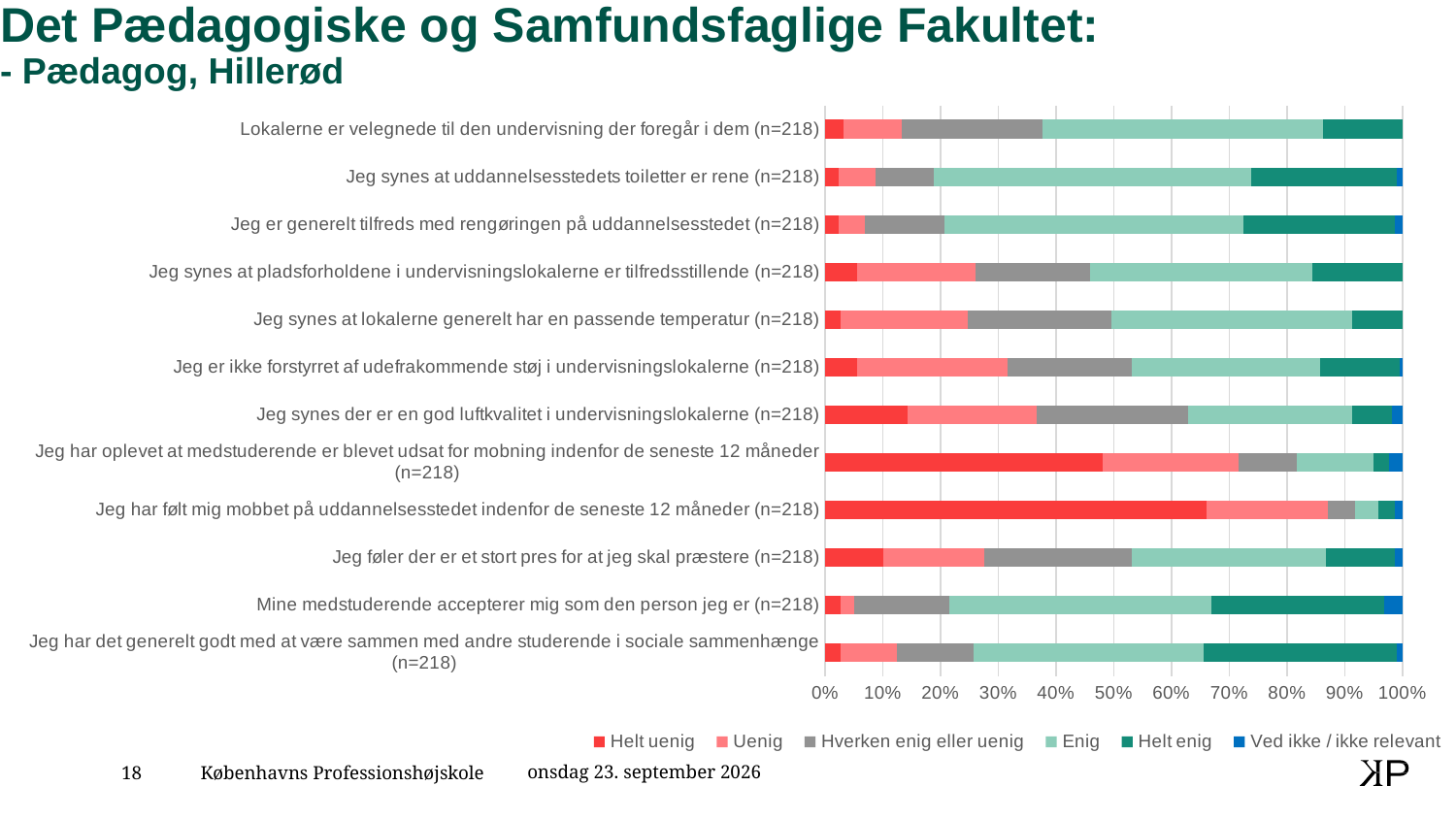
What is the sample size (n) shown for each statement in the chart? 218 How many series does the legend list? 6 How many statements (categories) are plotted in the chart? 12 Which statement has the largest 'Helt uenig' share? Jeg har følt mig mobbet på uddannelsesstedet indenfor de seneste 12 måneder (n=218) What is the highest value shown on the chart's horizontal axis? 100% Which has the larger 'Helt uenig' share: 'Jeg har følt mig mobbet på uddannelsesstedet indenfor de seneste 12 måneder' or 'Jeg har oplevet at medstuderende er blevet udsat for mobning indenfor de seneste 12 måneder'? Jeg har følt mig mobbet på uddannelsesstedet indenfor de seneste 12 måneder Is the 'Helt uenig' share for 'Jeg har oplevet at medstuderende er blevet udsat for mobning indenfor de seneste 12 måneder' greater or less than 40%? greater Is the 'Helt uenig' share for 'Lokalerne er velegnede til den undervisning der foregår i dem' greater or less than 10%? less Is the 'Helt uenig' share for 'Jeg har følt mig mobbet på uddannelsesstedet indenfor de seneste 12 måneder' greater or less than 60%? greater What is the last entry in the chart's legend? Ved ikke / ikke relevant What kind of chart is shown on the slide? Stacked bar chart